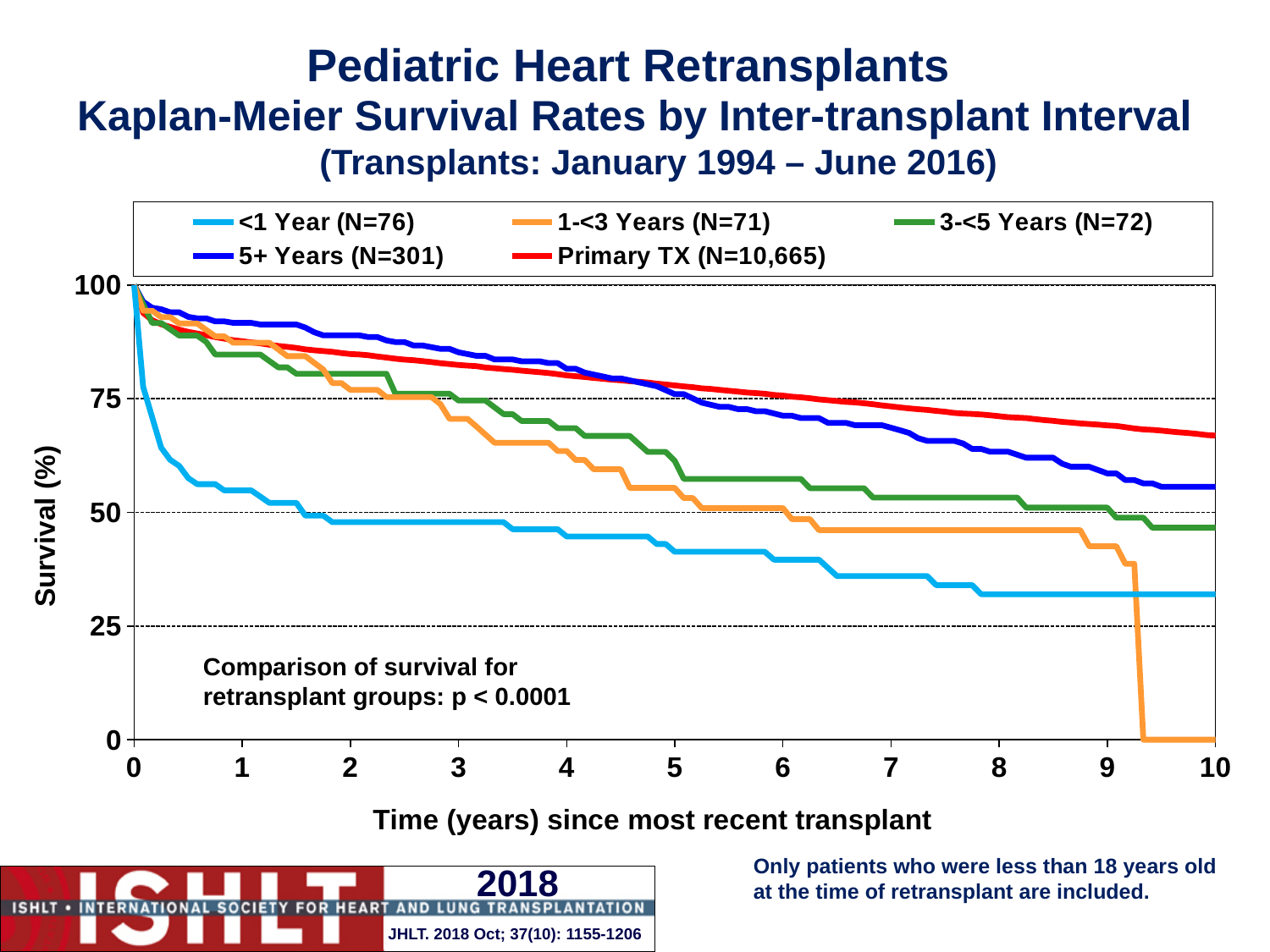
Which group has the lowest survival at 5 years since transplant? <1 Year (N=76) Is the survival for the Primary TX group at 5 years greater or less than 75? greater What is the N for the Primary TX series in the legend? 10,665 Do the survival curves rise or fall as time since transplant increases? fall What kind of chart is shown on the slide? line chart How many series does the legend list? 5 Which group has the highest survival at 10 years since transplant? Primary TX (N=10,665) Is the survival for the 5+ Years group at 10 years greater or less than 50? greater Is the survival for the Primary TX group at 10 years greater or less than 50? greater At 5 years, which has higher survival: the <1 Year group or the 3-<5 Years group? 3-<5 Years What p-value is given for the comparison of survival for retransplant groups? p < 0.0001